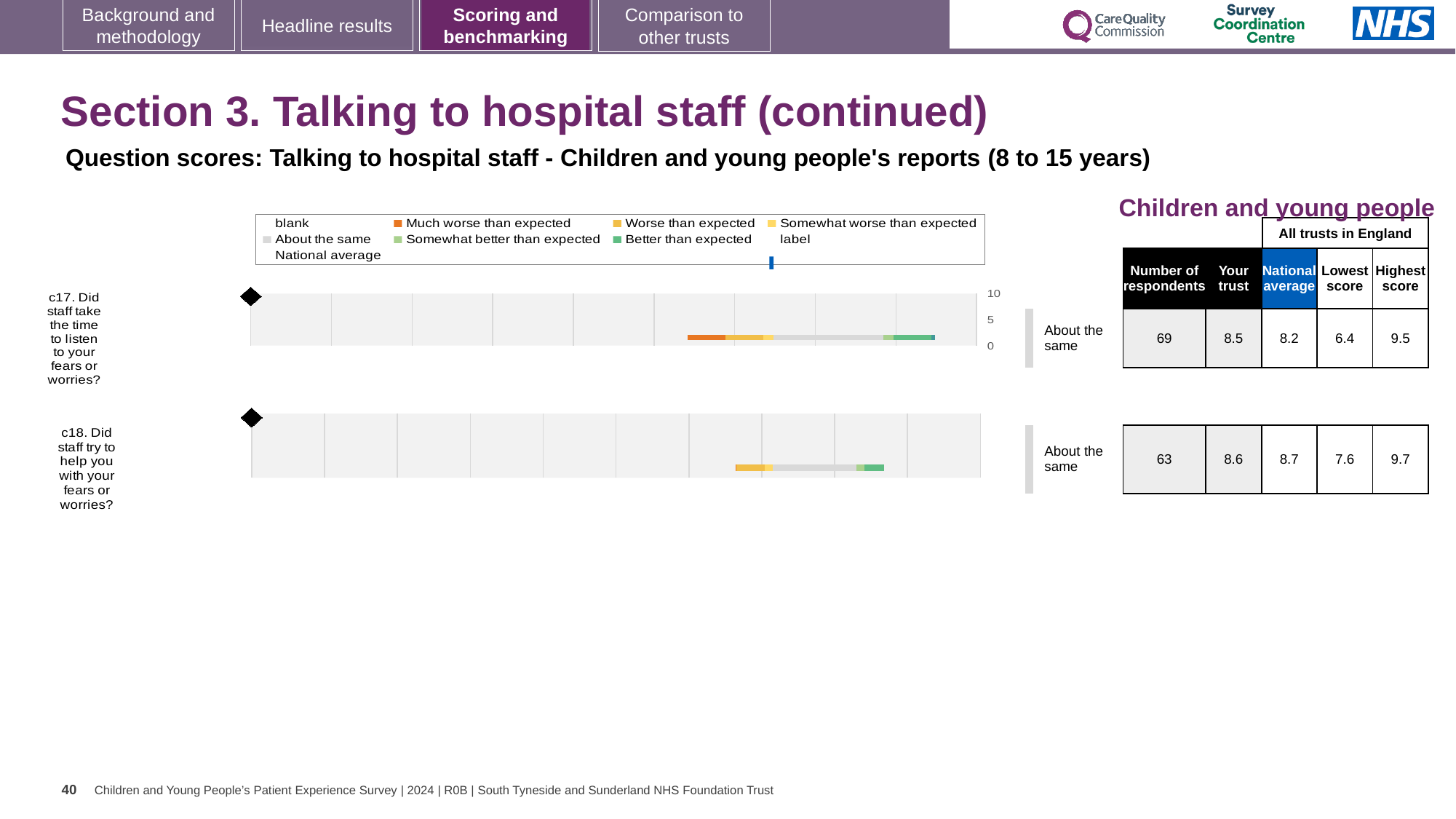
What is the 'Your trust' score for c17 (Did staff take the time to listen to your fears or worries?)? 8.5 What is the difference in the number of respondents between c17 and c18? 6 Which legend entry is shown in orange? Much worse than expected What is the national average score for c18 (Did staff try to help you with your fears or worries?)? 8.7 How many survey questions are plotted on the slide? 2 What is the difference between the highest score and the lowest score for c17? 3.1 What is the lowest score across all trusts in England for c17? 6.4 What is the number of respondents for c18? 63 What benchmark category is shown for c17? About the same Which question has the higher 'Your trust' score, c17 or c18? c18 Which question has the higher highest score across all trusts in England? c18 What kind of chart is used to show the benchmark results for c17 and c18? Bar chart